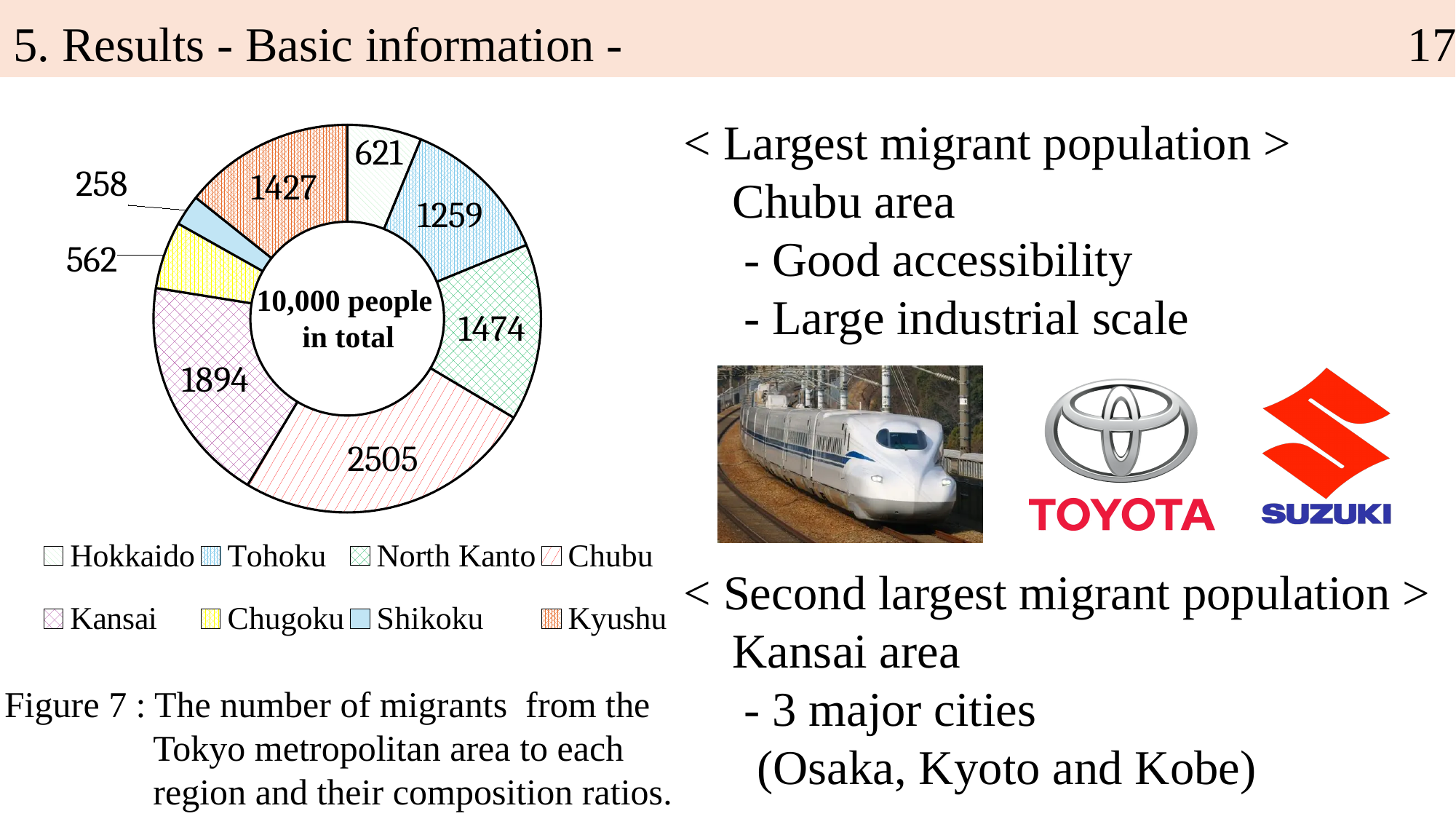
Which is larger, the value for Tohoku or the value for Kyushu? Kyushu What is the value for North Kanto in the chart? 1474 How many regions are shown in the chart? 8 What is the value for Kansai in the chart? 1894 What is the difference between the values for Chubu and Kansai? 611 What is the value for Shikoku in the chart? 258 What is the total of all the values in the chart? 10,000 What is the value for Chubu in the chart? 2505 What text is written in the centre of the doughnut chart? 10,000 people in total Which region has the largest slice in the chart? Chubu Which region has the smallest slice in the chart? Shikoku What kind of chart is shown in Figure 7? Doughnut (pie) chart